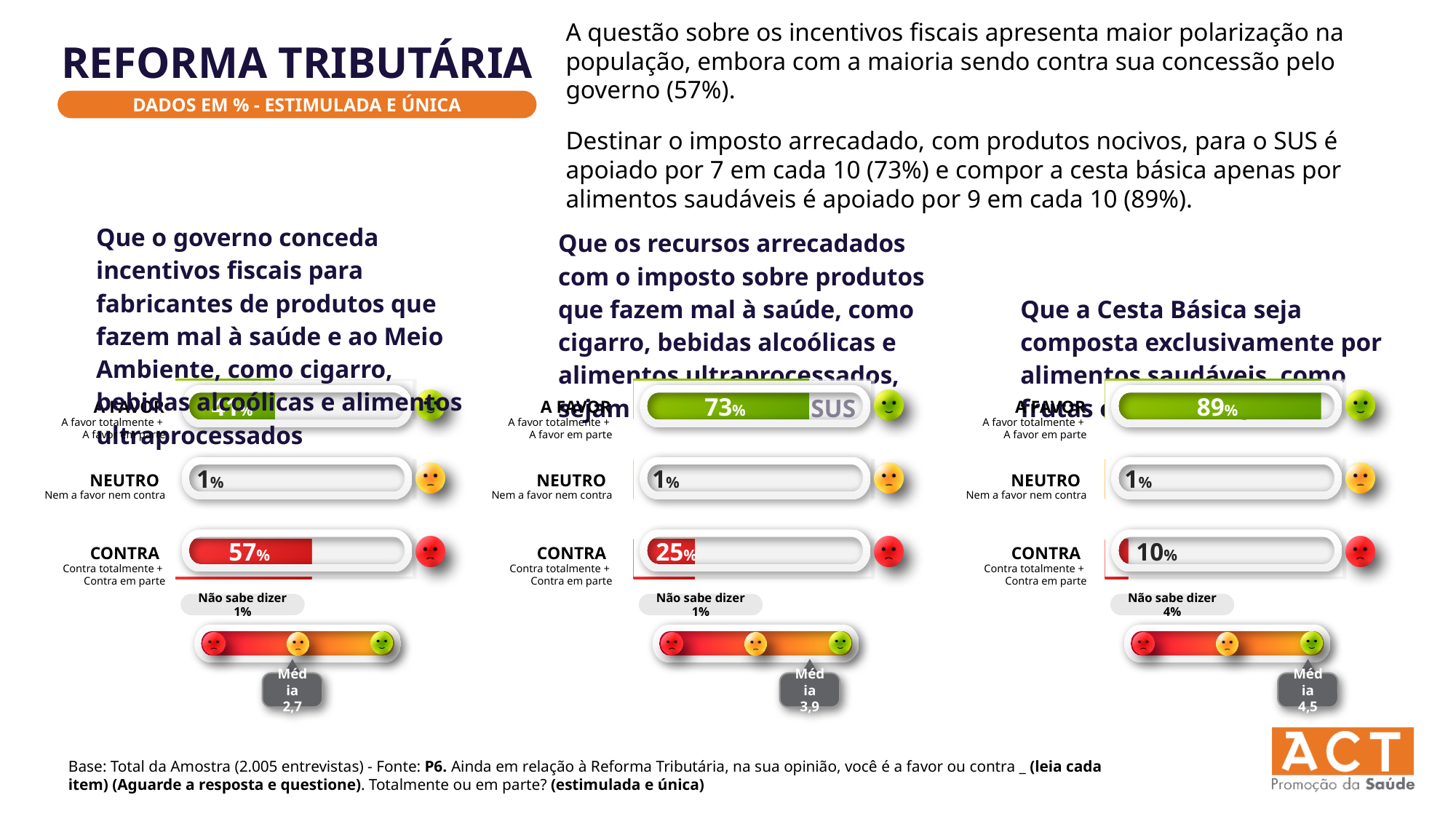
In the right chart (Cesta Básica), what is the difference between A FAVOR and CONTRA? 79% In the right chart (Cesta Básica), what is the 'Não sabe dizer' percentage? 4% In the right chart (Cesta Básica), what percentage is CONTRA? 10% What is the 'Média' value shown below the middle chart (SUS)? 3,9 Which of the three charts has the highest A FAVOR percentage? The right chart (Cesta Básica), 89% In the right chart (Cesta Básica composed exclusively of healthy foods), what percentage is A FAVOR? 89% In the middle chart (SUS), what percentage is CONTRA? 25% What is the 'Média' value shown below the right chart (Cesta Básica)? 4,5 In the left chart (tax incentives), which is larger, NEUTRO or CONTRA? CONTRA In the middle chart (revenue from taxes on harmful products going to the SUS), what percentage is A FAVOR? 73% In the left chart (government tax incentives for harmful products), what percentage is CONTRA? 57% In the middle chart (SUS), what is the difference between A FAVOR and CONTRA? 48%